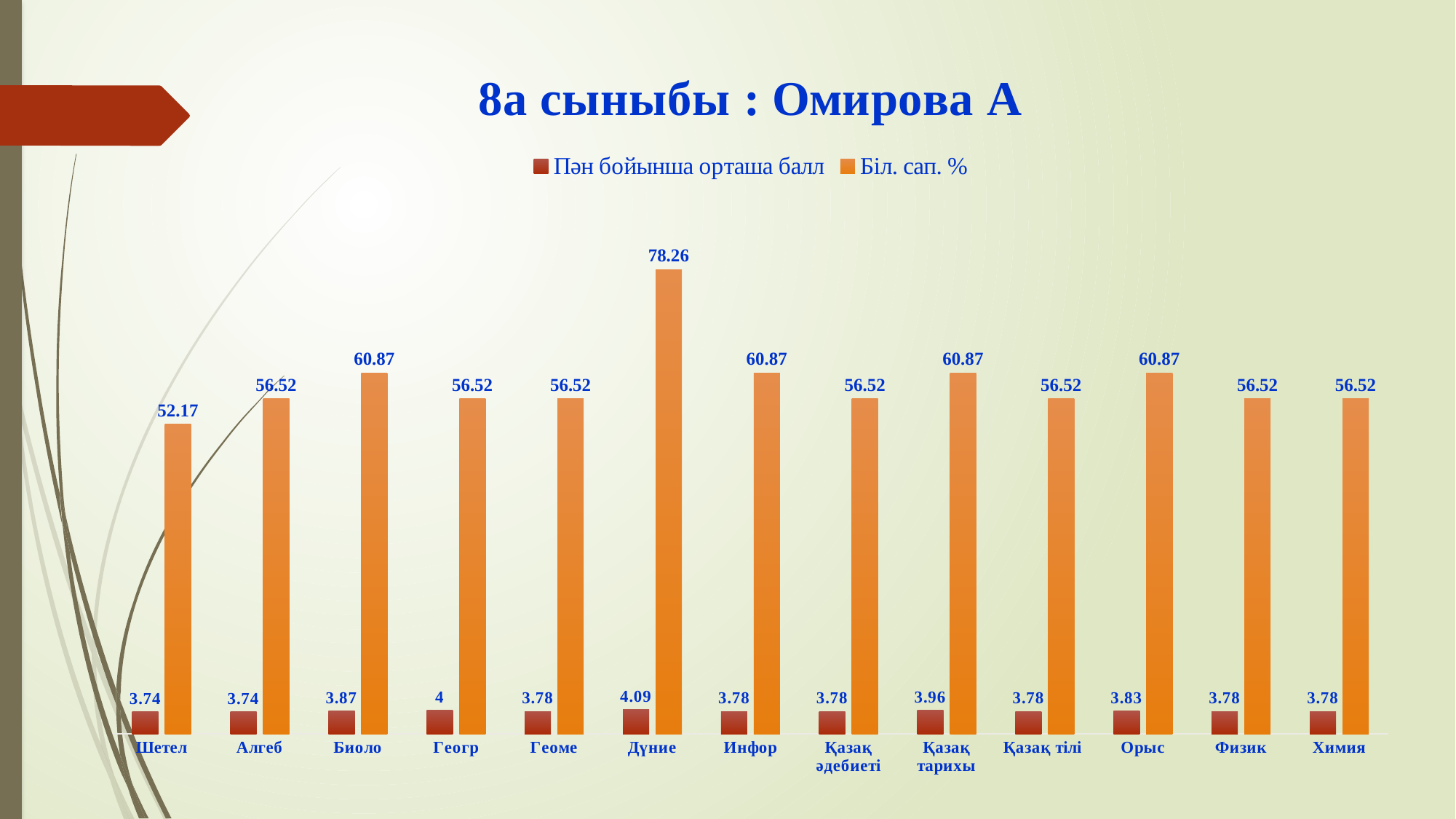
Which category has the highest Біл. сап. % value? Дүние How many series does the legend list? 2 Which category has the lowest Біл. сап. % value? Шетел What is the value of Пән бойынша орташа балл for Қазақ тарихы? 3.96 Which category has the highest Пән бойынша орташа балл value? Дүние How many categories are shown on the x axis? 13 What type of chart is shown on the slide? Bar chart What is the value of Пән бойынша орташа балл for Геогр? 4 What is the difference between the Біл. сап. % values for Дүние and Биоло? 17.39 What is the value of Біл. сап. % for Шетел? 52.17 What is the value of Біл. сап. % for Дүние? 78.26 Which is larger, the Біл. сап. % value for Орыс or for Физик? Орыс